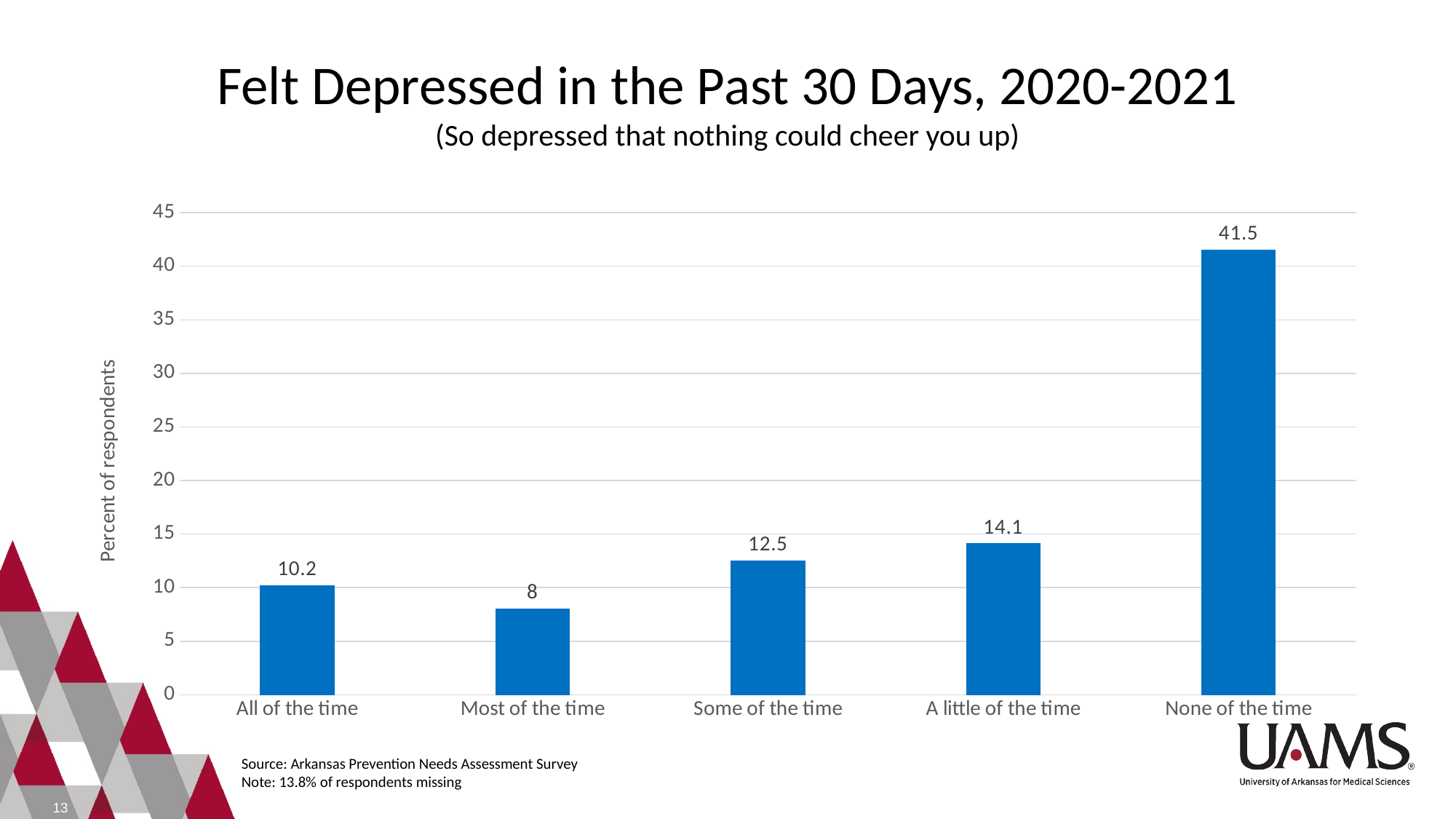
What is the label of the vertical axis? Percent of respondents What is the value for "A little of the time"? 14.1 What is the value for "None of the time"? 41.5 Is the value for "None of the time" greater or less than 40? greater How many categories are shown on the x axis? 5 What is the difference between the values for "None of the time" and "A little of the time"? 27.4 Which category has the lowest value? Most of the time What kind of chart is shown on the slide? Bar chart What is the value for "Most of the time"? 8 Which category has the highest value? None of the time What is the difference between the values for "Some of the time" and "Most of the time"? 4.5 Which is larger, the value for "All of the time" or the value for "Some of the time"? Some of the time